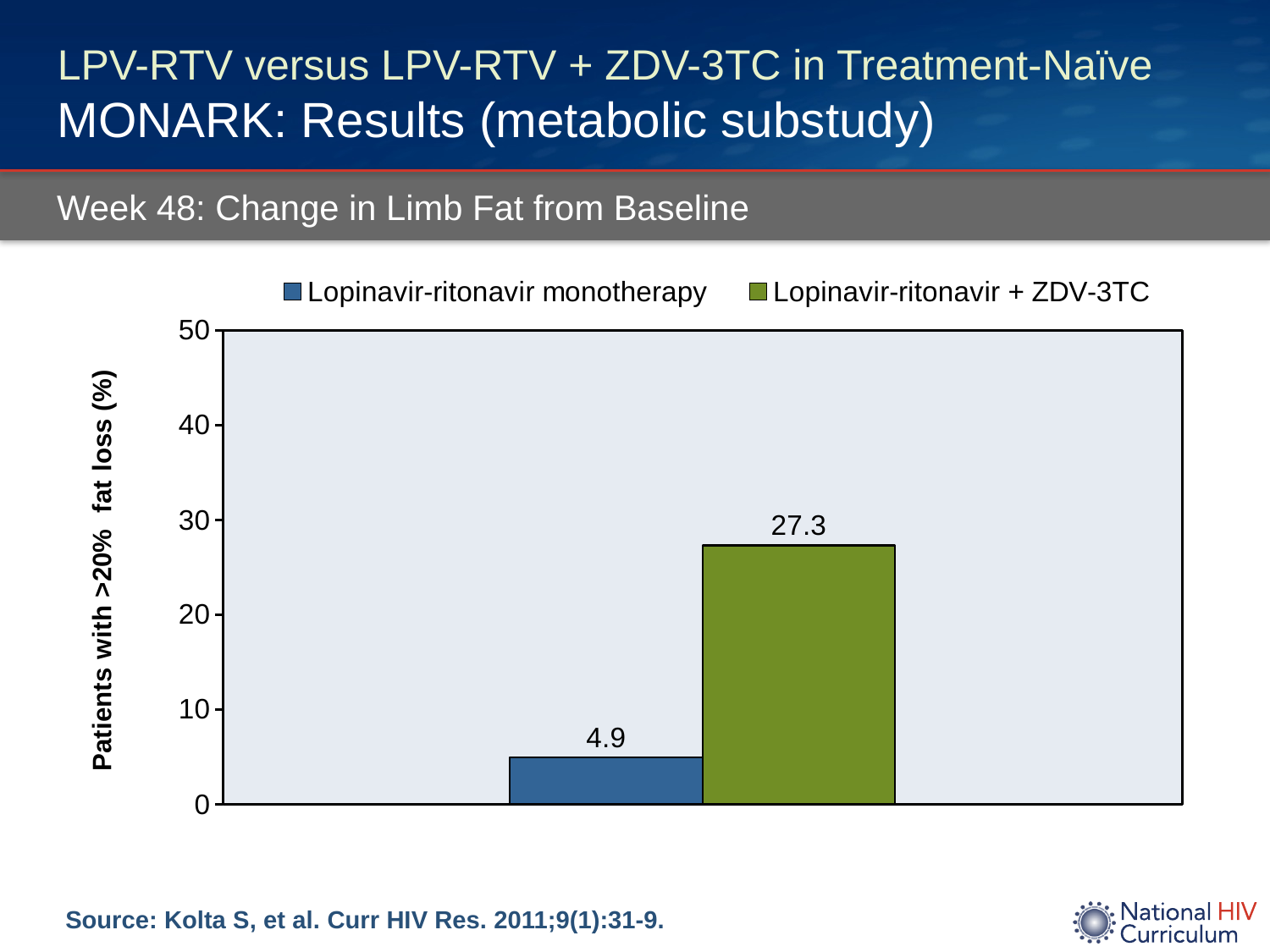
Is the value for Lopinavir-ritonavir + ZDV-3TC greater or less than 20? greater Is the value for Lopinavir-ritonavir monotherapy greater or less than 10? less How many bars are plotted in the chart? 2 What kind of chart is shown on the slide? Bar chart What is the label of the y-axis? Patients with >20% fat loss (%) How many series does the legend list? 2 What percentage of patients had >20% fat loss in the Lopinavir-ritonavir monotherapy group? 4.9 Is the value for Lopinavir-ritonavir + ZDV-3TC larger or smaller than the value for Lopinavir-ritonavir monotherapy? larger Which group had the lower percentage of patients with >20% fat loss? Lopinavir-ritonavir monotherapy What percentage of patients had >20% fat loss in the Lopinavir-ritonavir + ZDV-3TC group? 27.3 What is the difference in the percentage of patients with >20% fat loss between the Lopinavir-ritonavir + ZDV-3TC group and the monotherapy group? 22.4 Which group had the higher percentage of patients with >20% fat loss? Lopinavir-ritonavir + ZDV-3TC